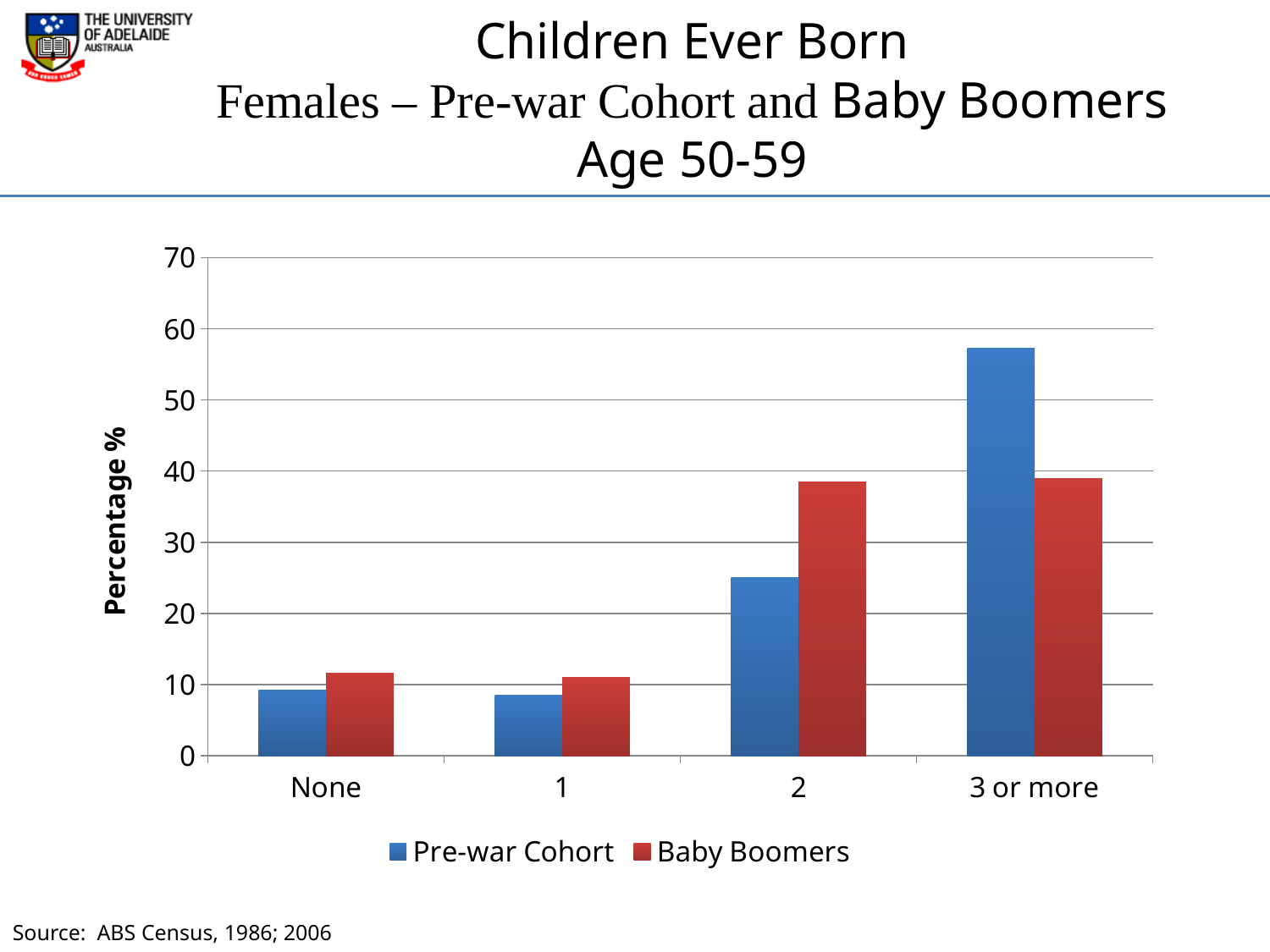
In the '2' category, which series has the larger value, Pre-war Cohort or Baby Boomers? Baby Boomers Is the value for the Pre-war Cohort in the '3 or more' category greater or less than 50? greater How many categories are shown on the x axis? 4 For the Pre-war Cohort, which category has the lowest value? 1 For the Pre-war Cohort, which category has the highest value? 3 or more What kind of chart is shown on the slide? bar chart How many series does the legend list? 2 Is the value for Baby Boomers in the '2' category greater or less than 30? greater What is the label on the vertical axis? Percentage % Which series is shown in blue? Pre-war Cohort Is the value for the Pre-war Cohort in the 'None' category greater or less than 10? less In the '3 or more' category, which series has the larger value, Pre-war Cohort or Baby Boomers? Pre-war Cohort